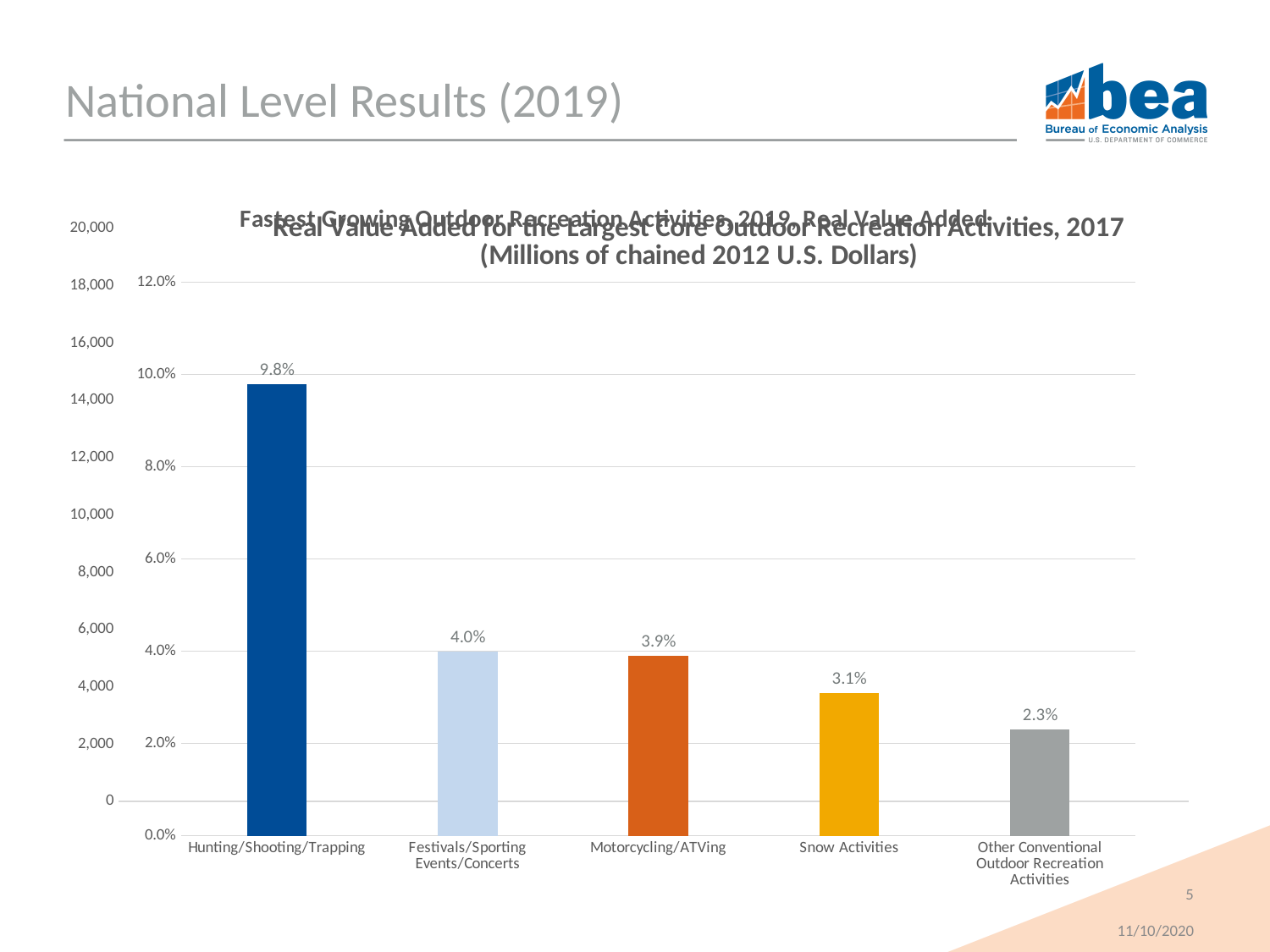
In the bar chart with percentage values, what is the difference between Hunting/Shooting/Trapping and Festivals/Sporting Events/Concerts? 5.8 percentage points In the bar chart with percentage values, what is the value for Hunting/Shooting/Trapping? 9.8% In the bar chart with percentage values, what is the value for Snow Activities? 3.1% In the bar chart with percentage values, is the value for Hunting/Shooting/Trapping greater or less than 8.0%? greater How many categories are shown in the bar chart with percentage values? 5 In the bar chart with percentage values, which category has the lowest value? Other Conventional Outdoor Recreation Activities In the bar chart with percentage values, which is larger: Snow Activities or Other Conventional Outdoor Recreation Activities? Snow Activities In the bar chart with percentage values, do the values rise or fall from left to right? fall In the bar chart with percentage values, what is the value for Motorcycling/ATVing? 3.9% In the bar chart with percentage values, what is the value for Other Conventional Outdoor Recreation Activities? 2.3% In the bar chart with percentage values, which category has the highest value? Hunting/Shooting/Trapping What kind of chart is used to show the percentage values on the slide? bar chart